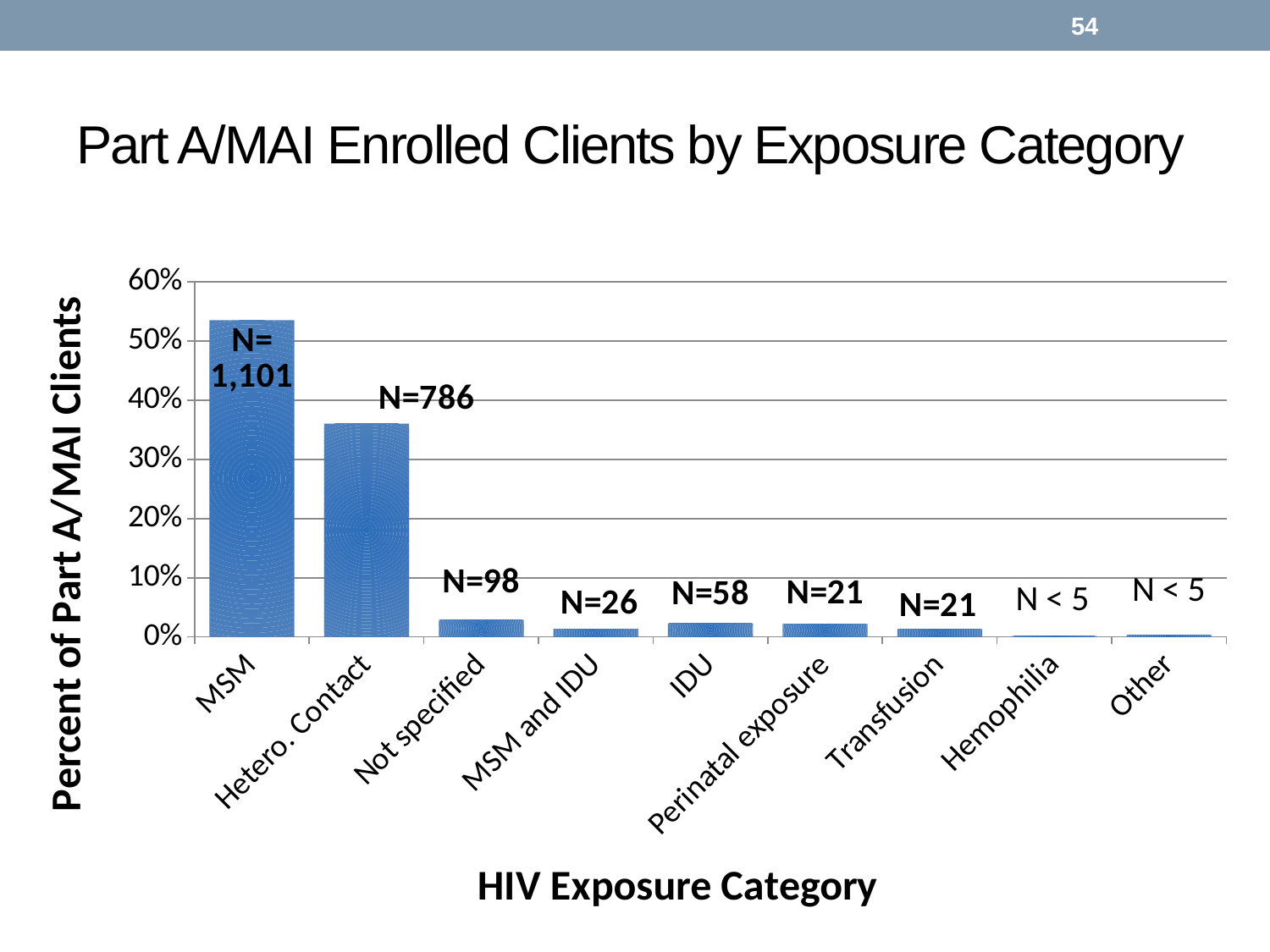
What is the N value labelled on the Not specified bar? 98 What kind of chart is shown on the slide? bar chart Is the percent value for MSM greater or less than 50%? greater What is the title of the x axis? HIV Exposure Category What is the N value labelled on the MSM bar? 1,101 What is the N value labelled on the IDU bar? 58 What label is shown above the Hemophilia bar? N < 5 Which exposure category has the highest percent of Part A/MAI clients? MSM What is the N value labelled on the Hetero. Contact bar? 786 What is the difference between the N values for MSM and Hetero. Contact? 315 How many HIV exposure categories are shown on the x axis? 9 Is the percent value for Hetero. Contact greater or less than 40%? less